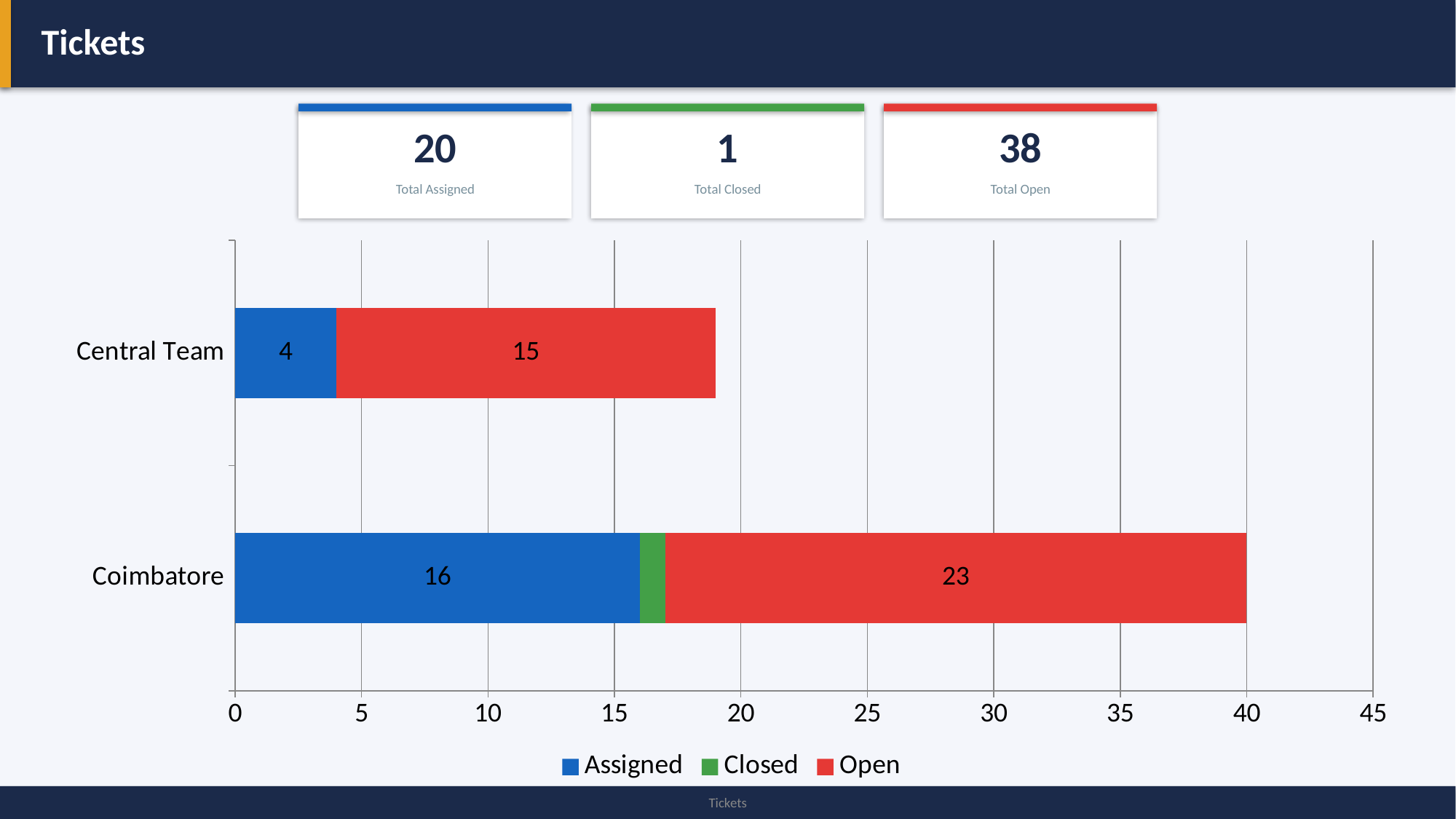
What is the difference between the Assigned values for Coimbatore and Central Team? 12 How many more Open tickets does Coimbatore have than Central Team? 8 Which category has more Open tickets, Coimbatore or Central Team? Coimbatore Is the total length of the Coimbatore bar greater or less than 30? greater How many categories are shown on the chart? 2 What is the Open value for Coimbatore? 23 How many series does the legend list? 3 What is the Assigned value for Coimbatore? 16 What kind of chart is shown on the slide? Stacked bar chart What is the Assigned value for Central Team? 4 Which category has the highest Assigned value? Coimbatore What is the Open value for Central Team? 15